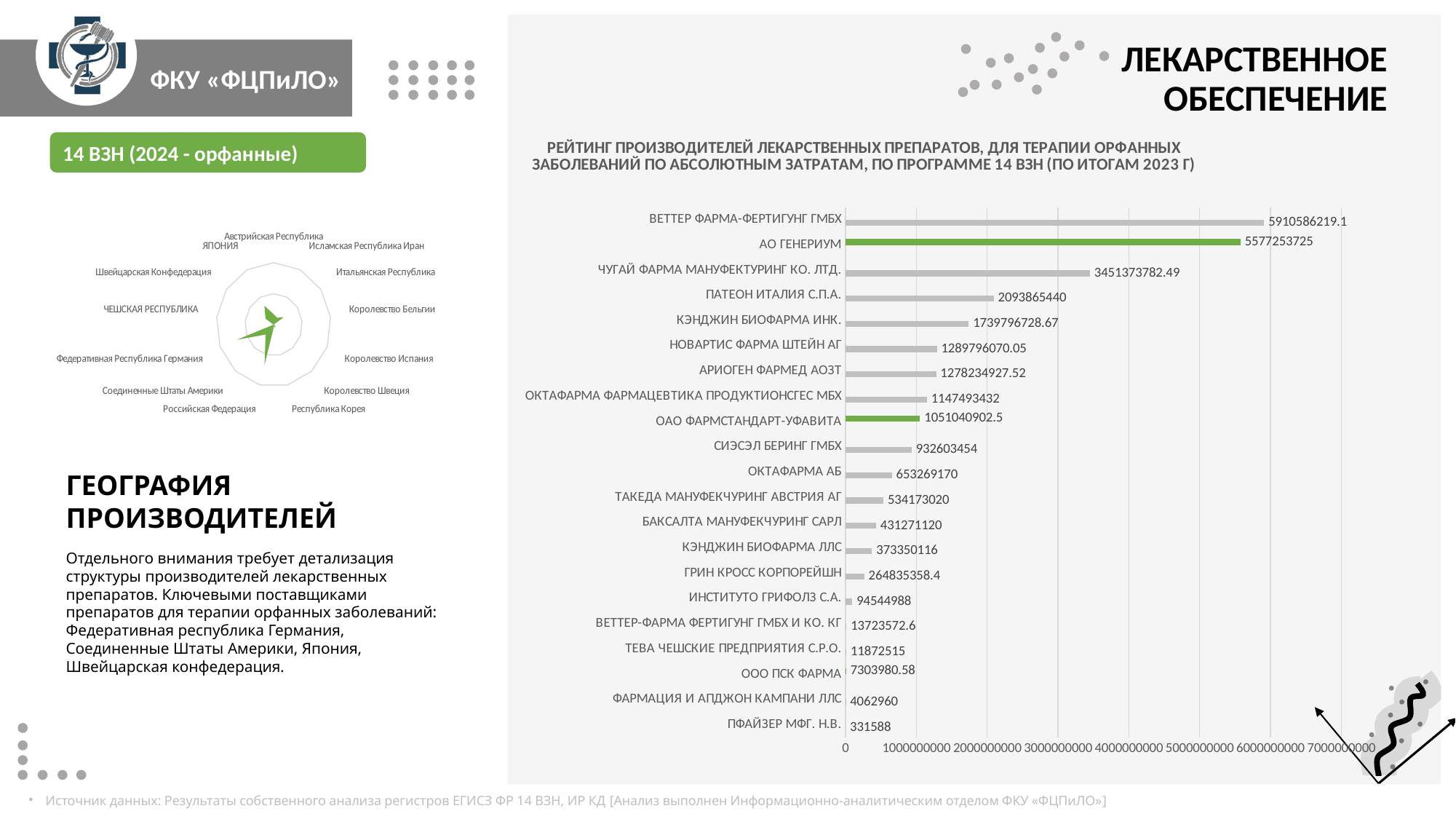
On the bar chart on the right, which manufacturer has the highest value? ВЕТТЕР ФАРМА-ФЕРТИГУНГ ГМБХ On the bar chart on the right, which manufacturer has the lowest value? ПФАЙЗЕР МФГ. Н.В. On the bar chart on the right, what is the value for ПФАЙЗЕР МФГ. Н.В.? 331588 How many manufacturers are listed on the bar chart on the right? 21 On the bar chart on the right, what is the difference between the values for ОКТАФАРМА АБ and ТАКЕДА МАНУФЕКЧУРИНГ АВСТРИЯ АГ? 119096150 On the bar chart on the right, is the value for СИЭСЭЛ БЕРИНГ ГМБХ greater or less than 1000000000? less On the bar chart on the right, what is the value for ПАТЕОН ИТАЛИЯ С.П.А.? 2093865440 On the bar chart on the right, which is larger: the value for ЧУГАЙ ФАРМА МАНУФЕКТУРИНГ КО. ЛТД. or the value for КЭНДЖИН БИОФАРМА ИНК.? ЧУГАЙ ФАРМА МАНУФЕКТУРИНГ КО. ЛТД. What type of chart is shown on the right side of the slide? Bar chart On the bar chart on the right, what is the value for АО ГЕНЕРИУМ? 5577253725 How many countries are labelled on the radar chart on the left? 13 On the bar chart on the right, what is the difference between the values for ВЕТТЕР ФАРМА-ФЕРТИГУНГ ГМБХ and АО ГЕНЕРИУМ? 333332494.1